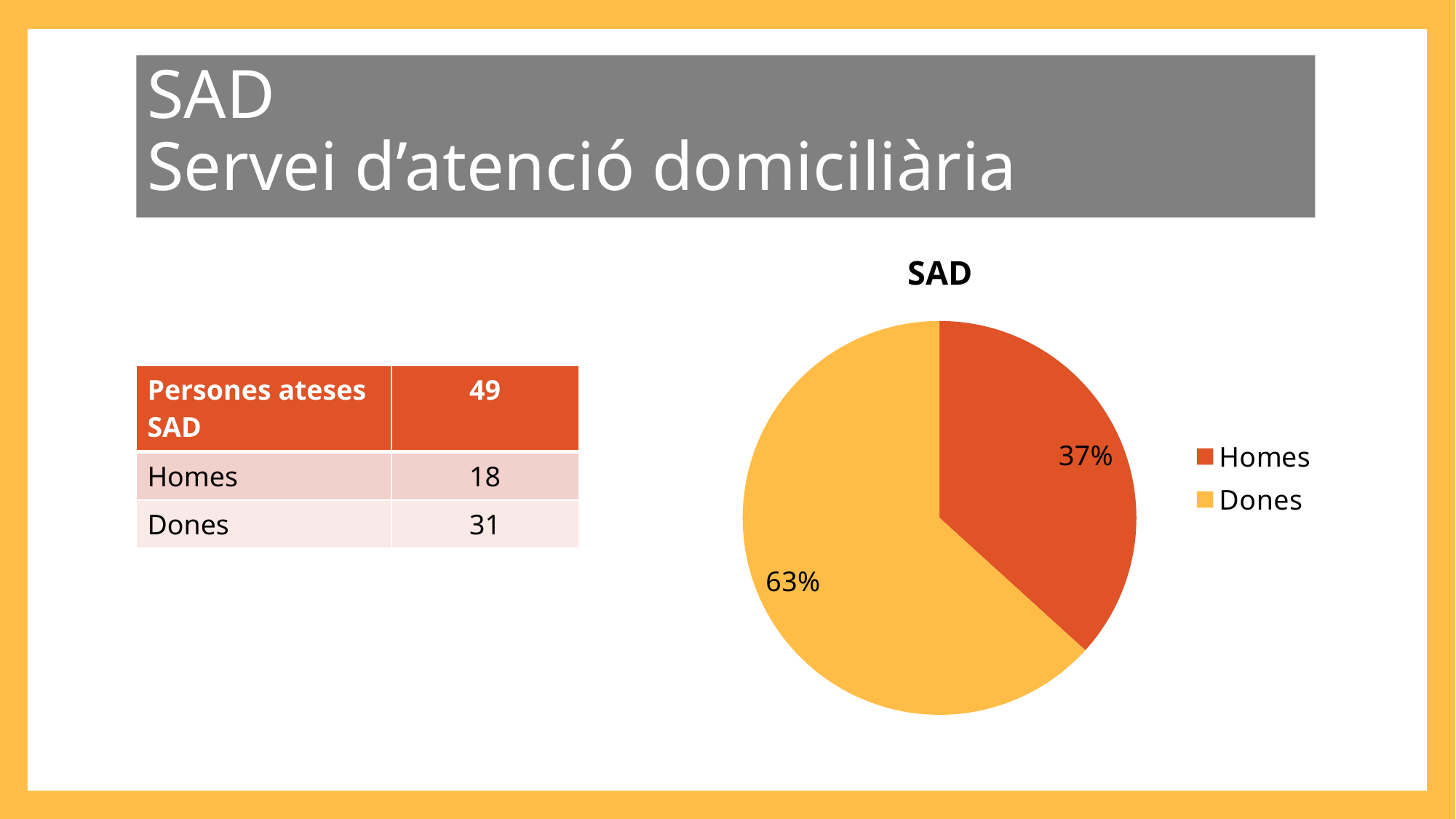
Is the share for Dones greater or less than 50%? greater What is the difference in percentage points between the Dones and Homes slices? 26 How many slices does the pie chart have? 2 What is the title of the chart? SAD What kind of chart is shown on the slide? pie chart Which colour represents Homes in the pie chart? orange-red How many entries does the legend list? 2 What share of the pie does Dones represent? 63% What share of the pie does Homes represent? 37% Which slice of the pie is the smallest? Homes Which slice of the pie is the largest? Dones Which is larger, the Homes slice or the Dones slice? Dones